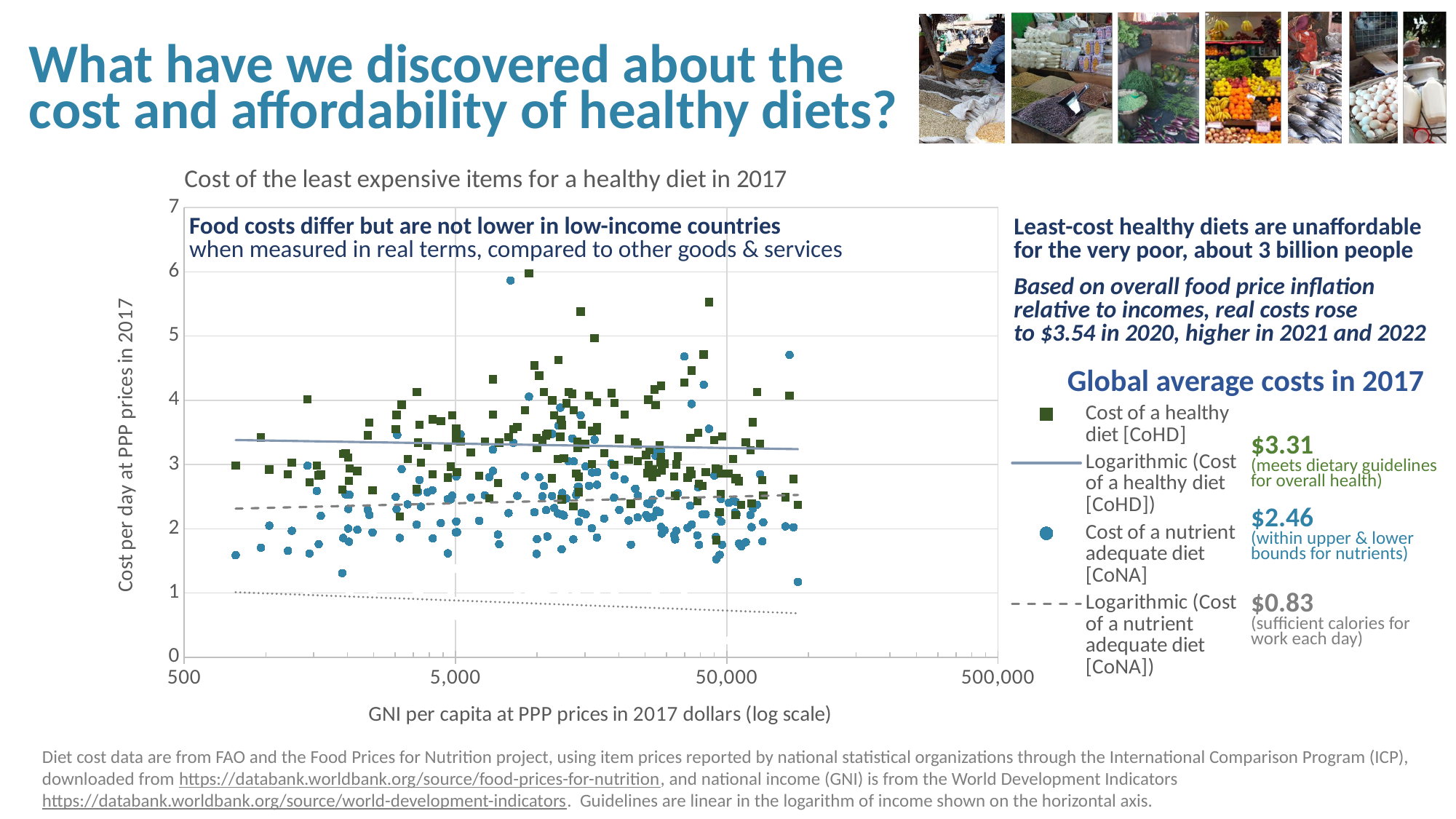
What is the global average cost of a healthy diet [CoHD] in 2017 shown on the slide? $3.31 Is the lowest plotted cost of a nutrient adequate diet [CoNA] point greater or less than 2? less What is the difference between the global average cost of a healthy diet ($3.31) and the cost of a nutrient adequate diet ($2.46)? $0.85 Is the highest plotted cost of a healthy diet [CoHD] point greater or less than 5? greater How many entries does the chart legend list? 4 What is the global average cost of a nutrient adequate diet [CoNA] in 2017 shown on the slide? $2.46 Which has the higher global average cost in 2017: the cost of a healthy diet [CoHD] or the cost of a nutrient adequate diet [CoNA]? Cost of a healthy diet [CoHD] Does the logarithmic trend line for the cost of a healthy diet [CoHD] rise or fall as GNI per capita increases? Fall What is the global average cost shown for sufficient calories for work each day? $0.83 What kind of chart is shown on the slide? Scatter chart What is the difference between the global average cost of a nutrient adequate diet ($2.46) and the cost of sufficient calories ($0.83)? $1.63 What is the title of the chart? Cost of the least expensive items for a healthy diet in 2017